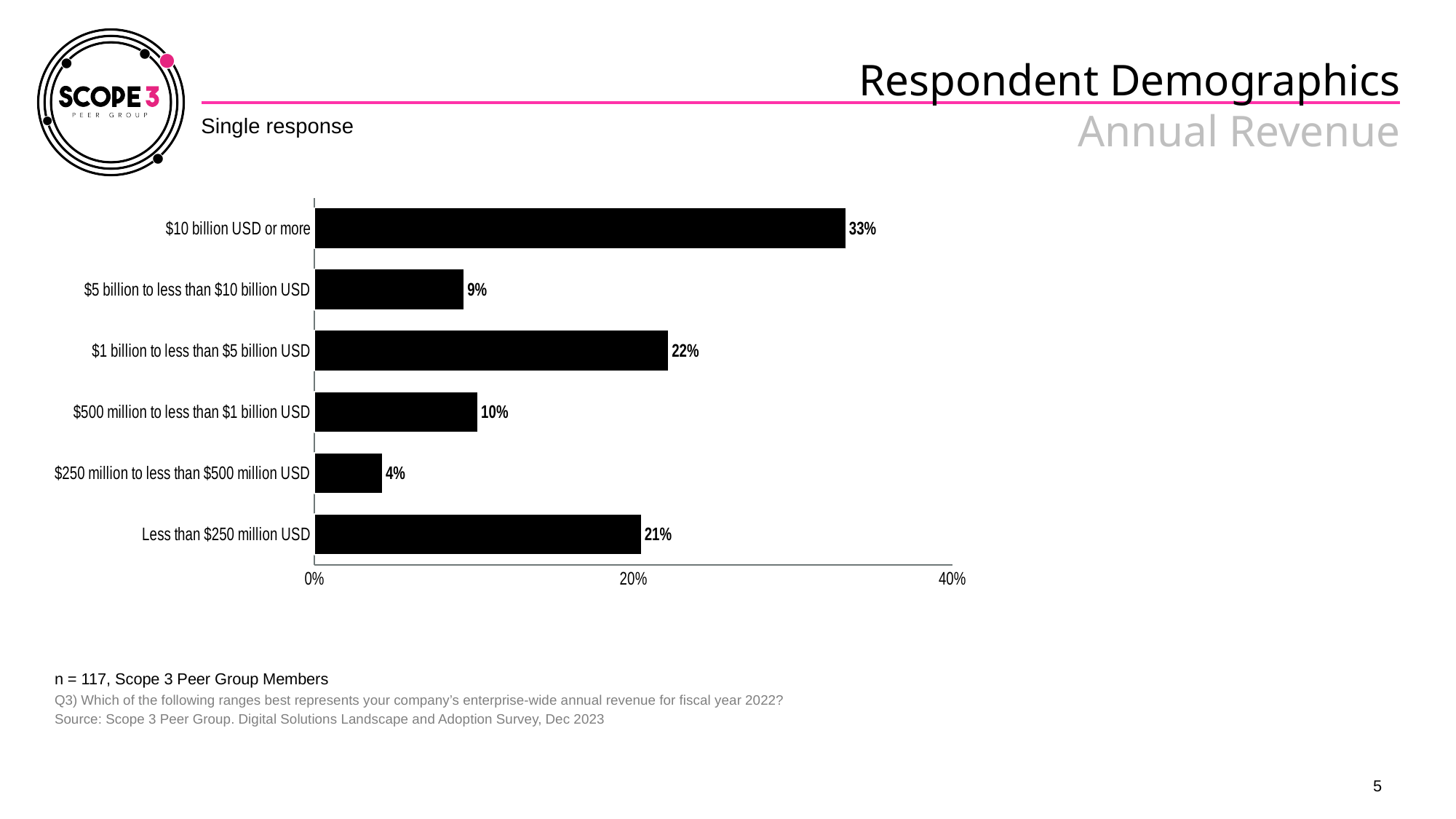
Which revenue category has the lowest percentage of respondents? $250 million to less than $500 million USD Which revenue category has the highest percentage of respondents? $10 billion USD or more How many revenue categories are shown in the chart? 6 Is the value for "$10 billion USD or more" greater or less than 20%? greater What type of chart is shown on the slide? bar chart What is the sample size (n) stated below the chart? 117 What is the difference between the "$10 billion USD or more" value and the "$1 billion to less than $5 billion USD" value? 11% Which is larger: the value for "$5 billion to less than $10 billion USD" or the value for "$500 million to less than $1 billion USD"? $500 million to less than $1 billion USD What percentage of respondents reported annual revenue of less than $250 million USD? 21% What is the value for the "$1 billion to less than $5 billion USD" category? 22% What percentage of respondents reported annual revenue of $10 billion USD or more? 33% What is the value for the "$250 million to less than $500 million USD" category? 4%